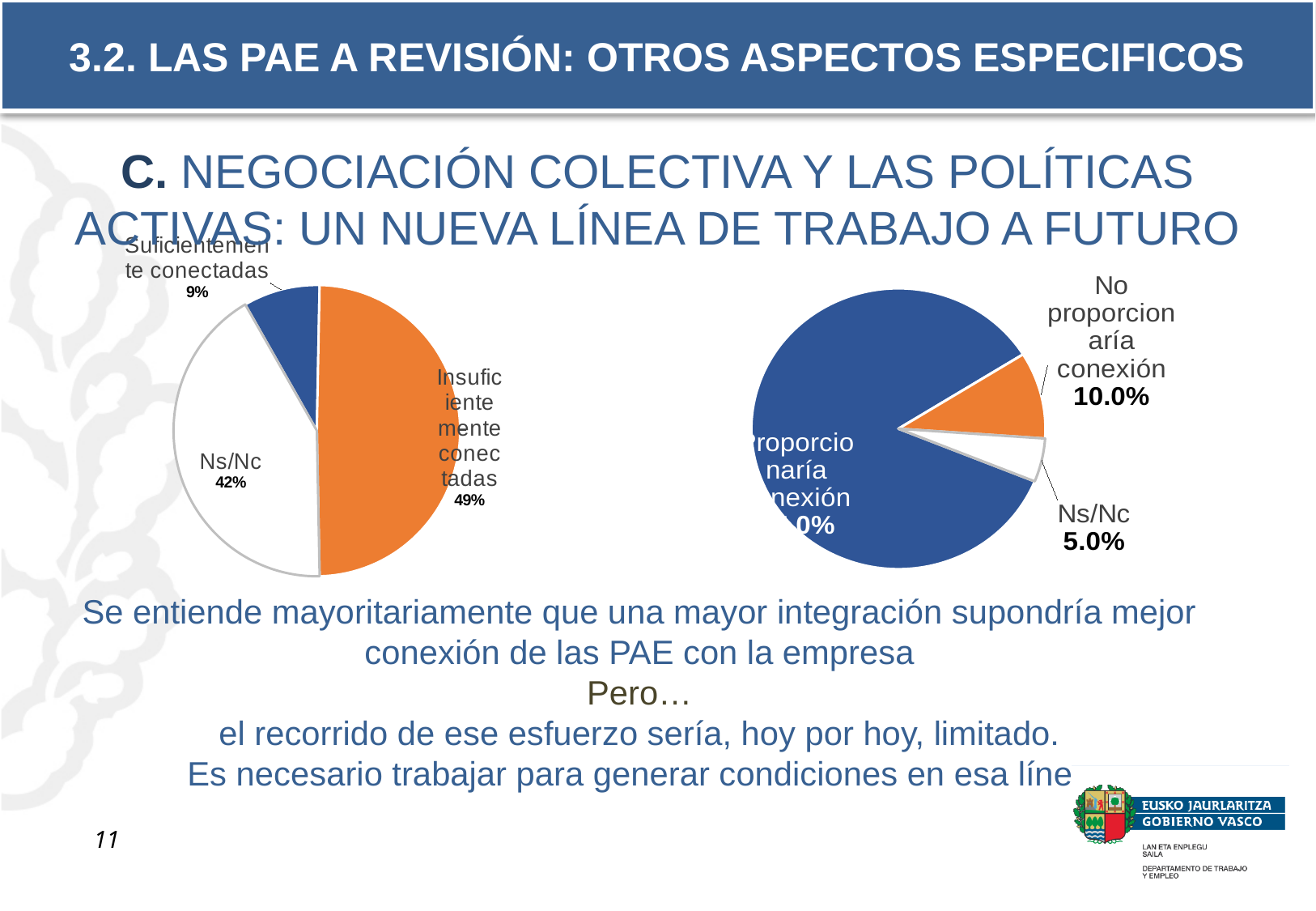
In the right pie chart, what percentage is shown for No proporcionaría conexión? 10.0% In the right pie chart, which is larger: No proporcionaría conexión or Ns/Nc? No proporcionaría conexión In the right pie chart, what percentage is shown for Ns/Nc? 5.0% In the left pie chart, what is the difference in percentage points between Insuficientemente conectadas and Ns/Nc? 7 In the right pie chart, which category has the smallest share? Ns/Nc In the left pie chart, what percentage is shown for Ns/Nc? 42% What type of chart is shown on the right side of the slide? Pie chart In the left pie chart, which category has the smallest share? Suficientemente conectadas In the left pie chart, what percentage is shown for Suficientemente conectadas? 9% How many slices does the left pie chart have? 3 In the left pie chart, what percentage is shown for Insuficientemente conectadas? 49% In the left pie chart, which category has the largest share? Insuficientemente conectadas